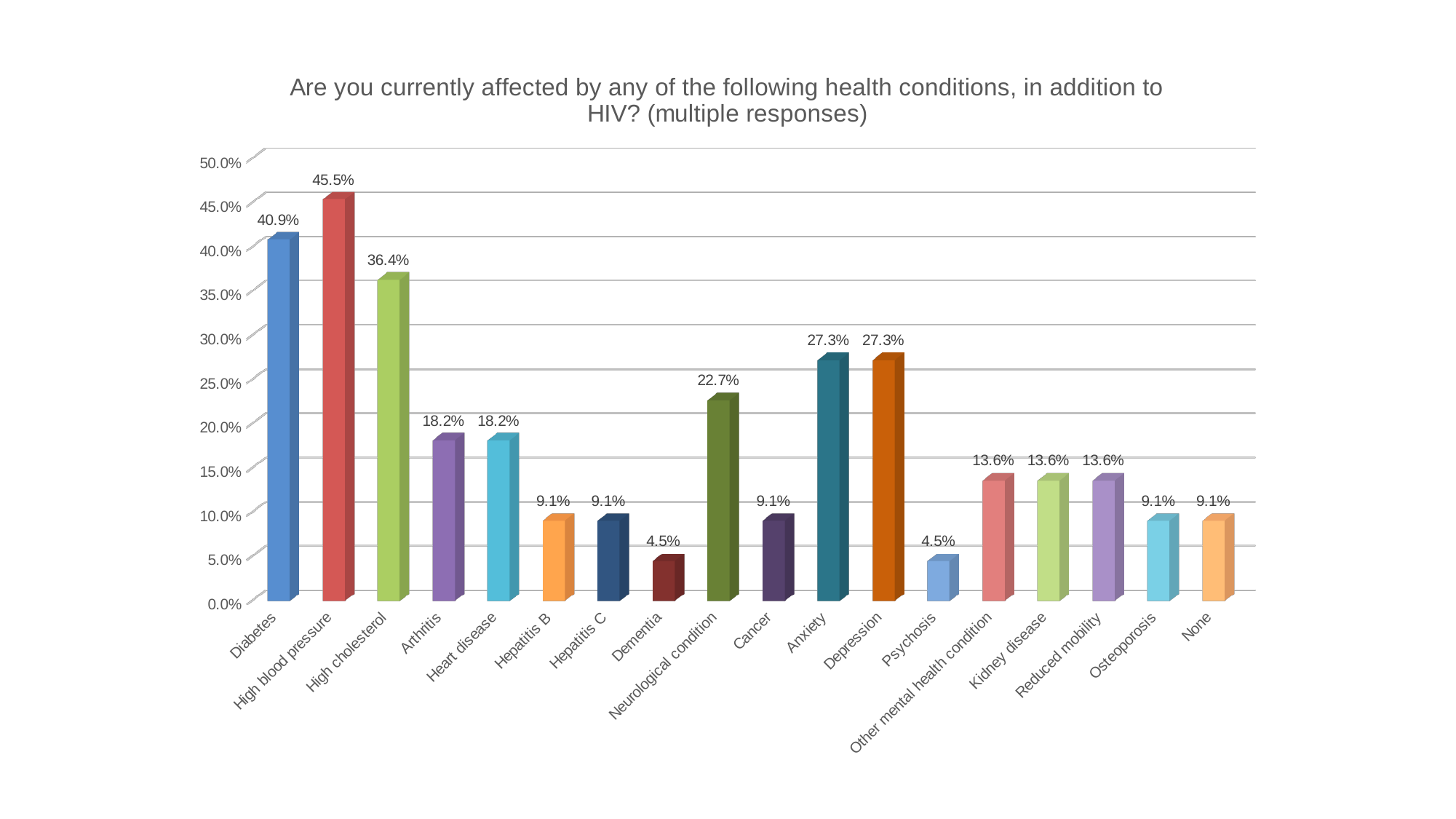
How many health condition categories are shown on the x axis? 18 Which is larger, the value for Arthritis or the value for Other mental health condition? Arthritis Which is larger, the value for Depression or the value for Neurological condition? Depression What percentage is shown for Kidney disease? 13.6% Which health condition has the highest percentage? High blood pressure What is the value for Diabetes? 40.9% What is the difference between the values for High blood pressure and High cholesterol? 9.1% What is the value shown for Neurological condition? 22.7% What is the difference between the values for Anxiety and Cancer? 18.2% What percentage of respondents reported high blood pressure? 45.5% What is the title of the chart? Are you currently affected by any of the following health conditions, in addition to HIV? (multiple responses) What kind of chart is shown on the slide? Bar chart